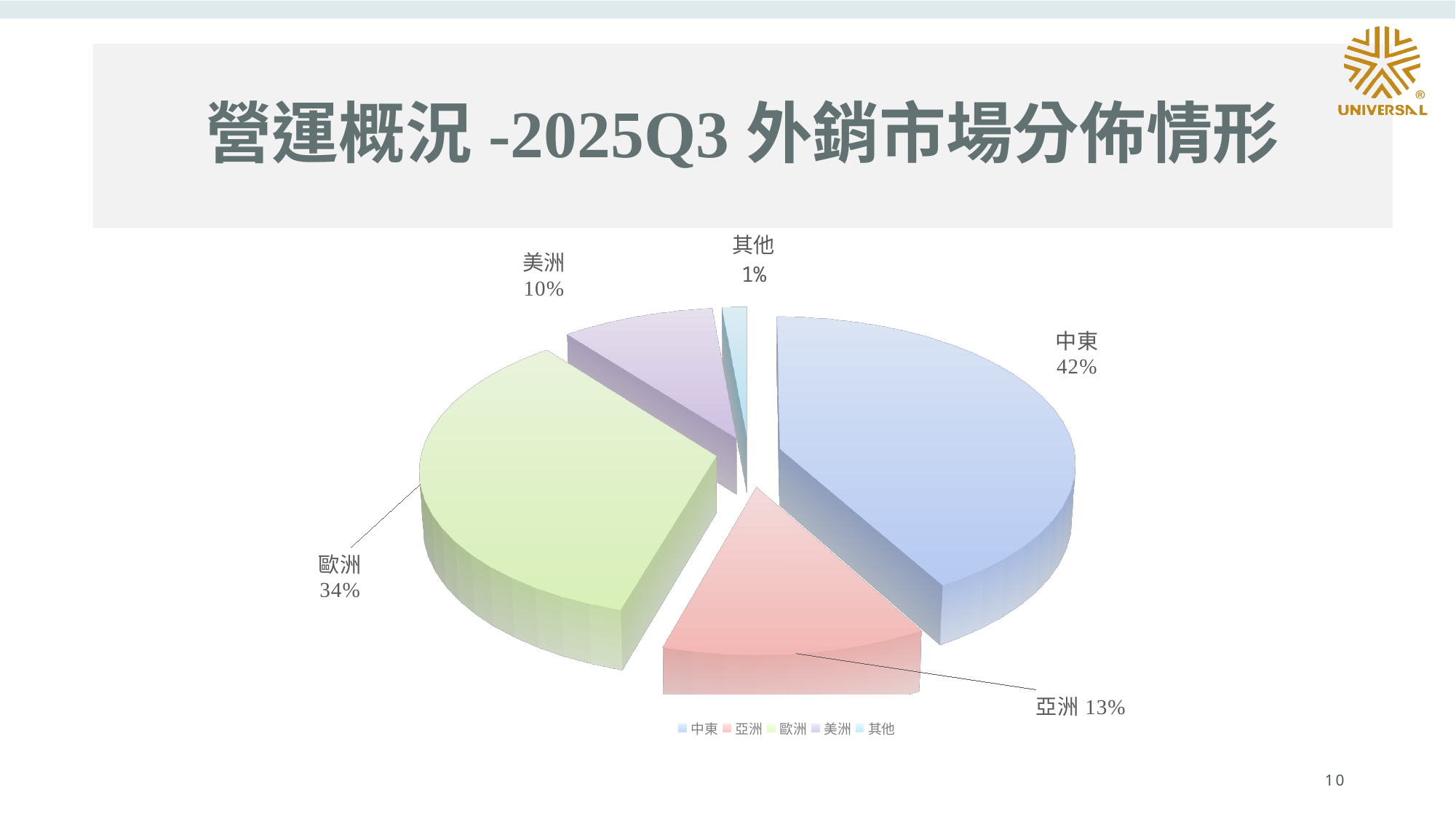
What is the difference in percentage points between the shares of 中東 and 歐洲? 8 What share of the pie does 亞洲 account for? 13% What kind of chart is shown on the slide? Pie chart What share of the pie does 其他 account for? 1% Which region has the largest share of the pie? 中東 What share of the pie does 美洲 account for? 10% How many entries does the legend list? 5 What share of the pie does 歐洲 account for? 34% What share of the pie does 中東 account for? 42% Which has a larger share, 亞洲 or 美洲? 亞洲 How many slices does the pie chart have? 5 Which region has the smallest share of the pie? 其他